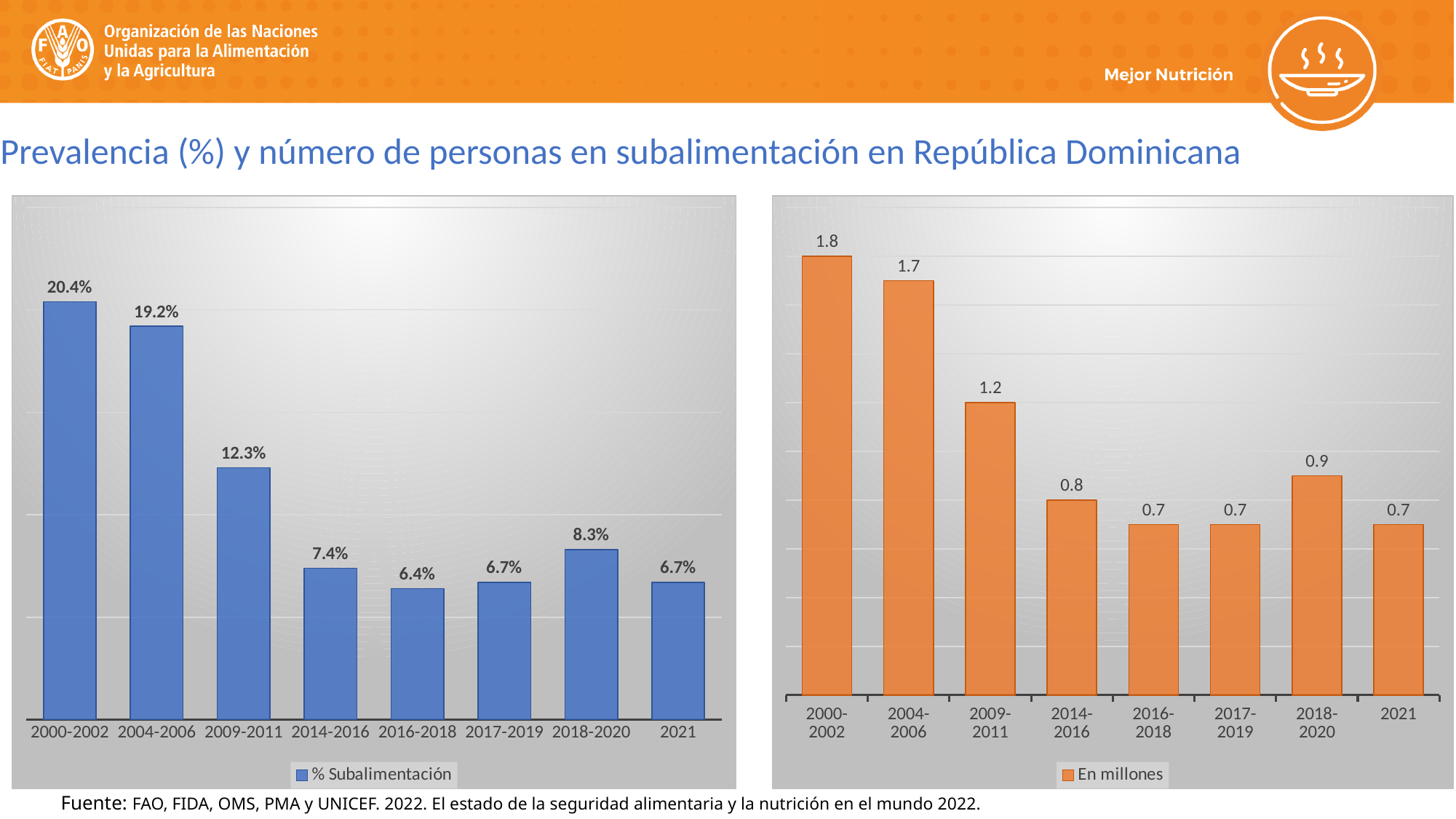
In the left chart (% Subalimentación), what is the difference between the values for 2000-2002 and 2021? 13.7% In the left chart (% Subalimentación), which period has the lowest value? 2016-2018 In the left chart (% Subalimentación), how many periods are shown on the x axis? 8 In the left chart (% Subalimentación), what is the value for 2000-2002? 20.4% In the left chart (% Subalimentación), what is the value for 2016-2018? 6.4% In the right chart (En millones), what is the value for 2018-2020? 0.9 In the left chart (% Subalimentación), which period has the highest value? 2000-2002 What is the legend entry of the left chart? % Subalimentación In the right chart (En millones), which is larger, the value for 2004-2006 or the value for 2014-2016? 2004-2006 In the right chart (En millones), which period has the highest value? 2000-2002 What kind of chart is the right chart (En millones)? Bar chart In the right chart (En millones), what is the value for 2009-2011? 1.2